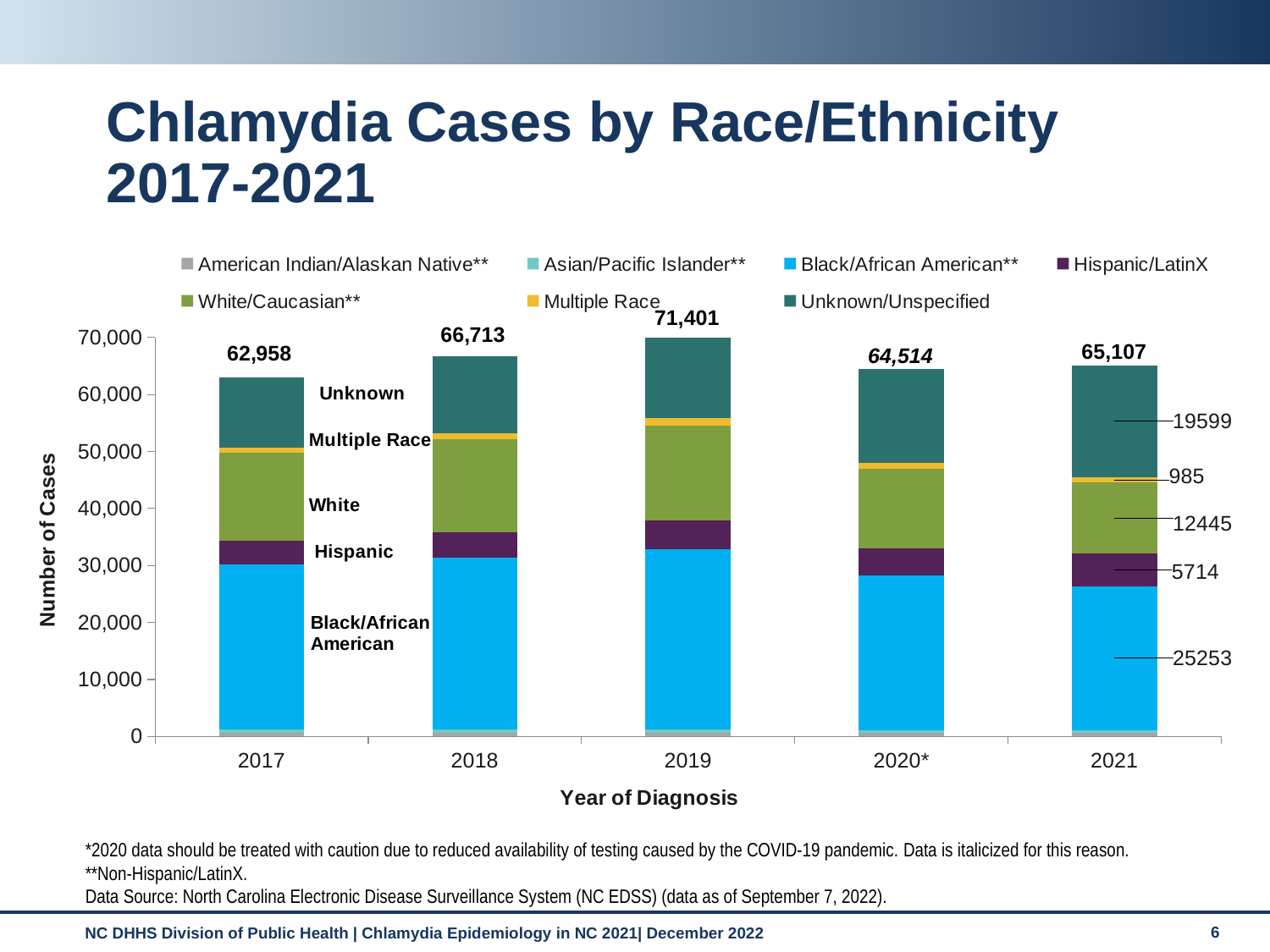
How many years are shown on the x axis? 5 What is the difference between the total cases in 2019 and 2018? 4,688 Which year has the highest total number of chlamydia cases? 2019 Which year has more total cases, 2020* or 2021? 2021 Which year has the lowest total number of chlamydia cases? 2017 How many Black/African American cases are labeled on the 2021 bar? 25253 How many race/ethnicity series does the legend list? 7 How many Hispanic/LatinX cases are labeled on the 2021 bar? 5714 How many Unknown/Unspecified cases are labeled on the 2021 bar? 19599 What is the total number of chlamydia cases shown for 2019? 71,401 What type of chart is shown on the slide? Stacked bar chart What is the total number of chlamydia cases shown for 2017? 62,958